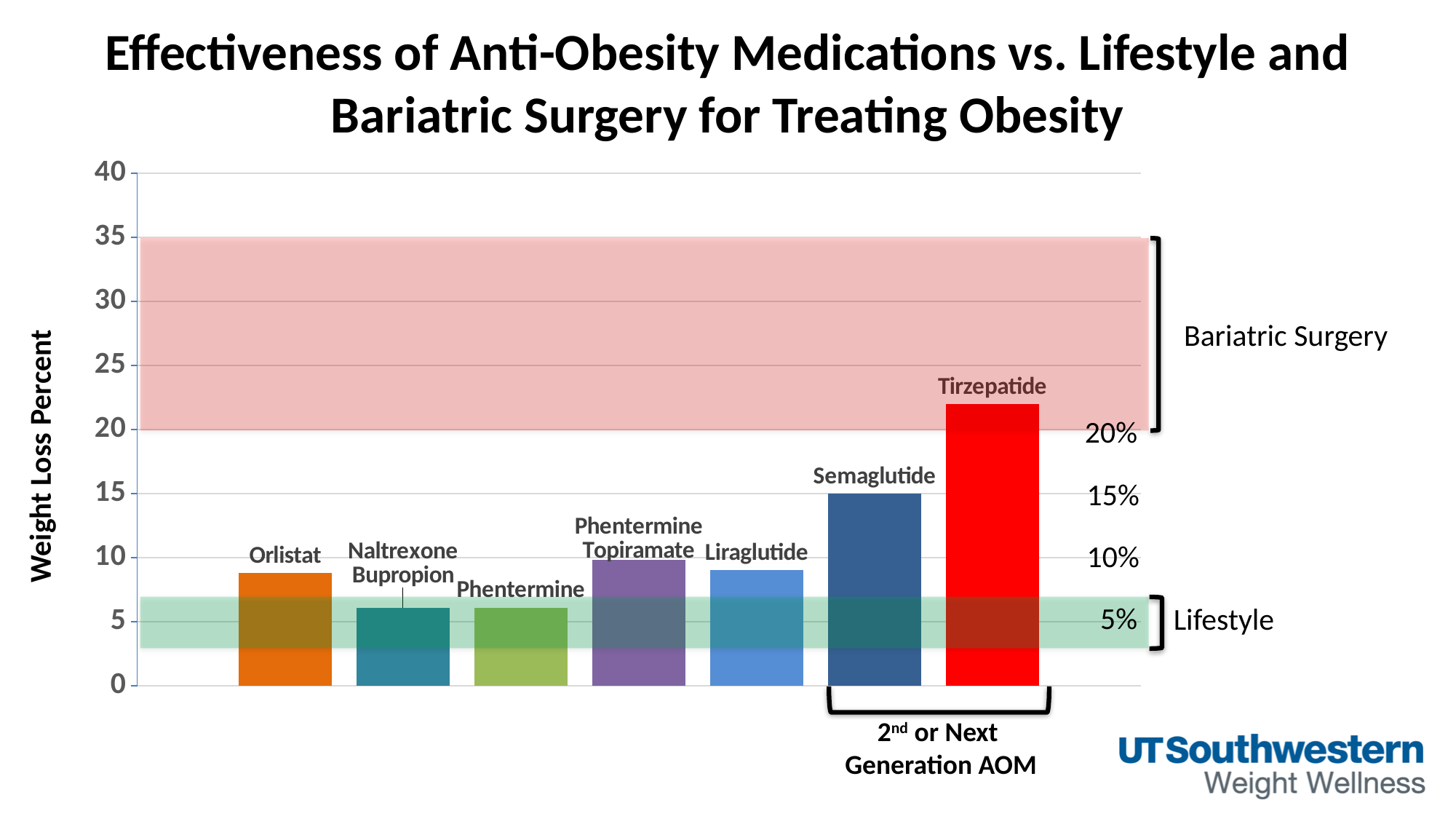
How many medication bars are plotted in the chart? 7 What is the weight loss percent for Semaglutide? 15 Is the value for Orlistat greater or less than 10? less Which has a larger weight loss percent, Tirzepatide or Semaglutide? Tirzepatide What kind of chart is shown on the slide? bar chart Is the value for Phentermine greater or less than 5? greater Is the value for Liraglutide greater or less than 10? less What is the title of the y axis? Weight Loss Percent Which medication has the highest weight loss percent in the chart? Tirzepatide Which two medications are grouped under the bracket labelled '2nd or Next Generation AOM'? Semaglutide and Tirzepatide Which has a larger weight loss percent, Orlistat or Phentermine? Orlistat